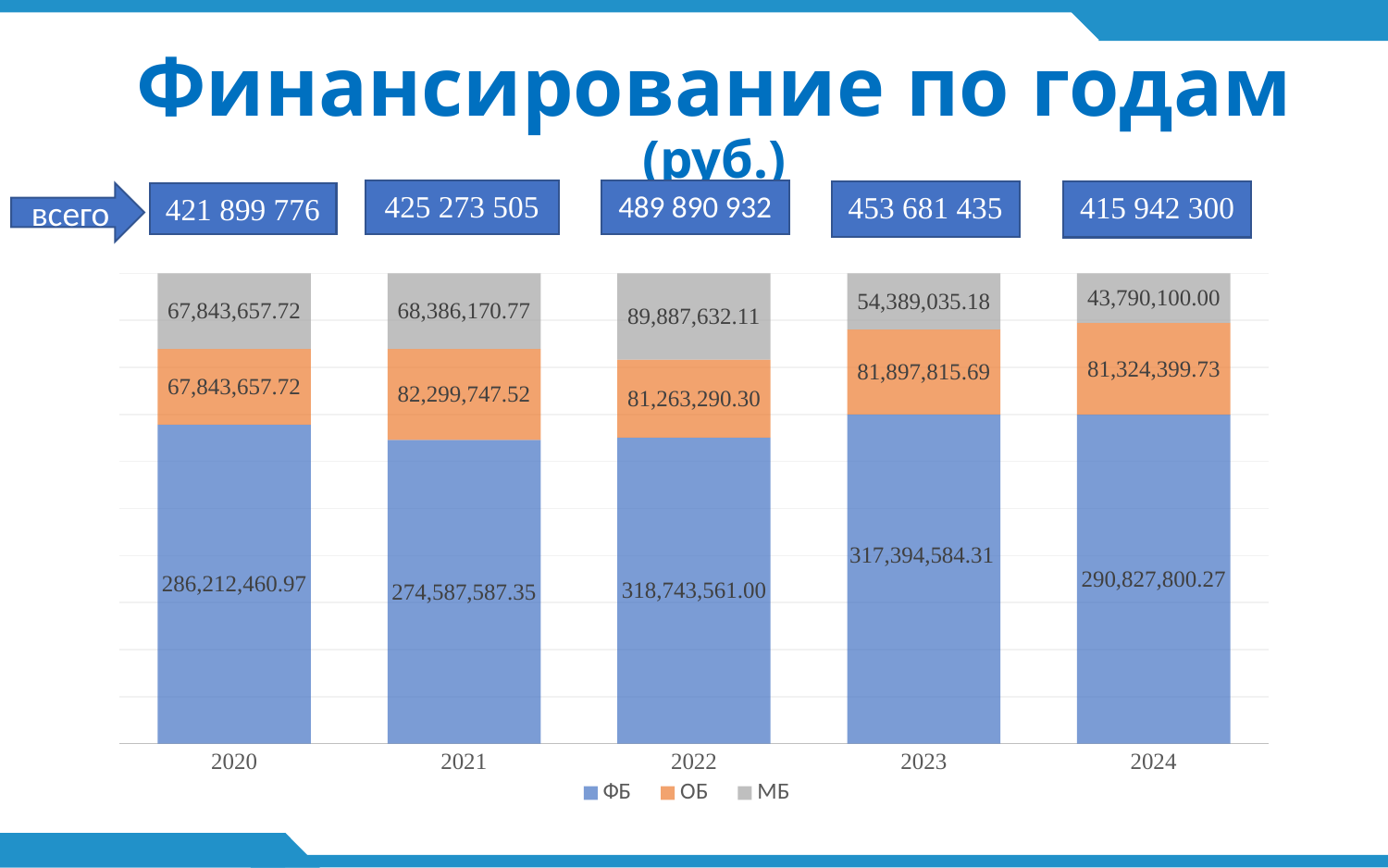
What is the value of ОБ for 2021? 82,299,747.52 In which year is the МБ value the lowest? 2024 What kind of chart is shown on the slide? Stacked bar chart How many series does the legend list? 3 What total (всего) is shown for 2020 above the chart? 421 899 776 What is the value of МБ for 2024? 43,790,100.00 What is the value of ФБ for 2022? 318,743,561.00 What is the difference between the ОБ value for 2023 and the ОБ value for 2024? 573,415.96 How many years are shown on the x axis? 5 Which year has the larger ФБ value, 2020 or 2021? 2020 In which year is the МБ value the highest? 2022 What is the difference between the МБ value for 2020 and the МБ value for 2024? 24,053,557.72